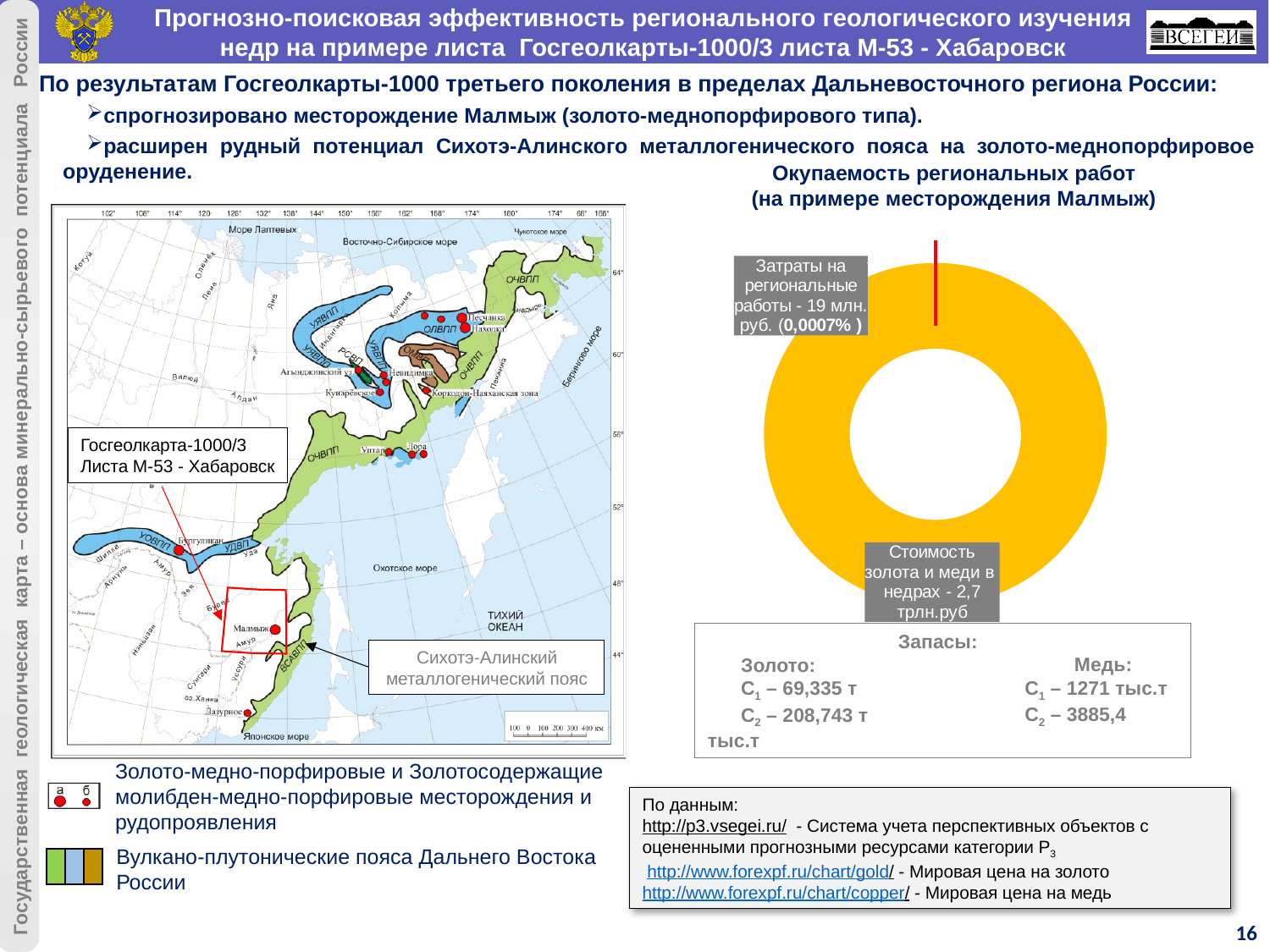
How many segments does the doughnut chart «Окупаемость региональных работ» have? 2 What colour is the large segment of the doughnut chart «Окупаемость региональных работ»? Yellow (orange-yellow) Which segment of the doughnut chart «Окупаемость региональных работ» is the smallest? Затраты на региональные работы What kind of chart is shown under the title «Окупаемость региональных работ (на примере месторождения Малмыж)»? Doughnut (pie) chart Which segment of the doughnut chart «Окупаемость региональных работ» is the largest? Стоимость золота и меди в недрах In the doughnut chart «Окупаемость региональных работ», what share of the whole do the regional work costs («Затраты на региональные работы») represent? 0,0007% In the doughnut chart «Окупаемость региональных работ», what value is given for «Затраты на региональные работы»? 19 млн. руб. What is the title of the doughnut chart on the right side of the slide? Окупаемость региональных работ (на примере месторождения Малмыж) In the doughnut chart «Окупаемость региональных работ», what value is given for «Стоимость золота и меди в недрах»? 2,7 трлн.руб In the doughnut chart «Окупаемость региональных работ», which segment is larger: «Затраты на региональные работы» or «Стоимость золота и меди в недрах»? Стоимость золота и меди в недрах